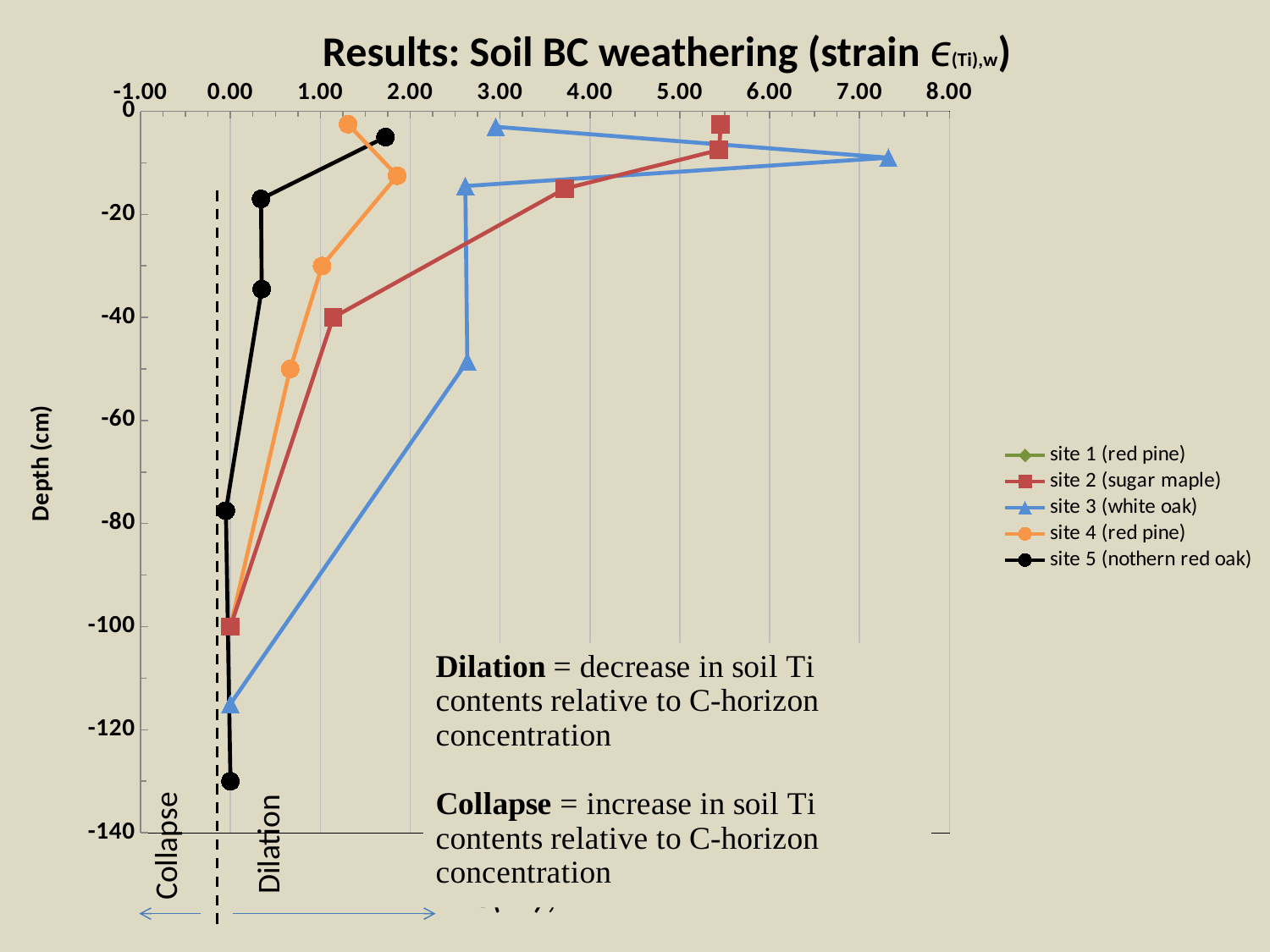
Does the strain for site 2 (sugar maple) generally increase or decrease as depth increases below the surface? decrease Is the strain for site 2 (sugar maple) at a depth of -100 cm greater or less than 1.00? less What colour is used for site 3 (white oak) in the legend? blue What kind of chart is shown on the slide? line chart Which series reaches the highest strain value on the chart? site 3 (white oak) Which series has its deepest plotted point: site 4 (red pine) or site 5 (nothern red oak)? site 5 (nothern red oak) How many data points are plotted for site 4 (red pine)? 5 Is the highest strain value for site 3 (white oak) greater or less than 7.00? greater Is the strain for site 3 (white oak) at a depth of about -50 cm greater or less than 2.00? greater What is the title of the vertical axis? Depth (cm) How many series does the legend list? 5 How many data points are plotted for site 2 (sugar maple)? 5